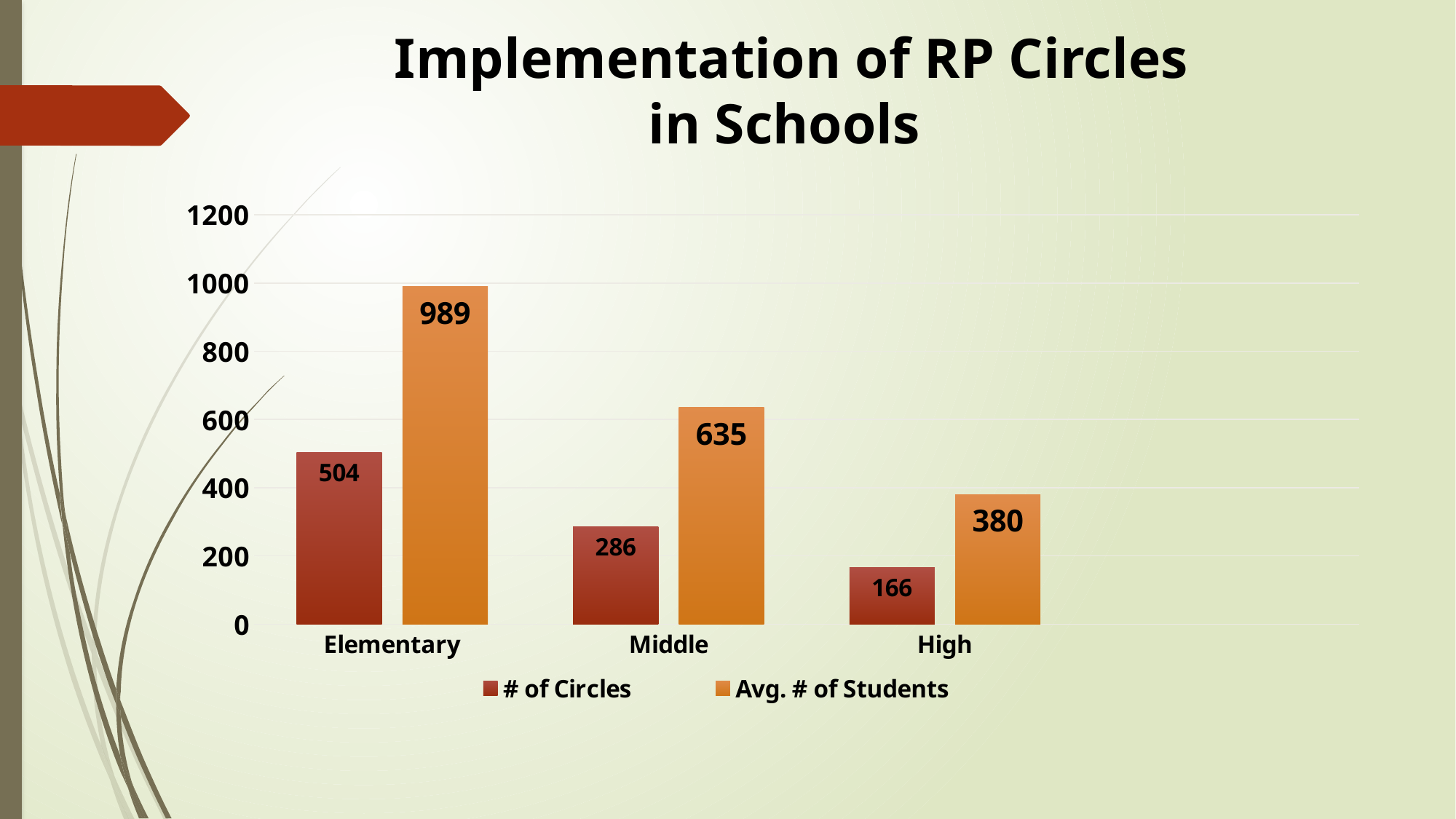
What is the # of Circles for Elementary schools? 504 What kind of chart is shown on the slide? Bar chart Which school level has the lowest # of Circles? High How many series does the legend list? 2 What is the difference between the Avg. # of Students for Elementary and High schools? 609 Which is larger: the # of Circles for Middle schools or the Avg. # of Students for High schools? Avg. # of Students for High schools Which school level has the highest Avg. # of Students? Elementary How many school levels are shown on the x axis? 3 What is the # of Circles for High schools? 166 Is the Avg. # of Students for Elementary schools greater or less than 800? greater Does the # of Circles rise or fall from Elementary to High? Fall What is the Avg. # of Students for Middle schools? 635